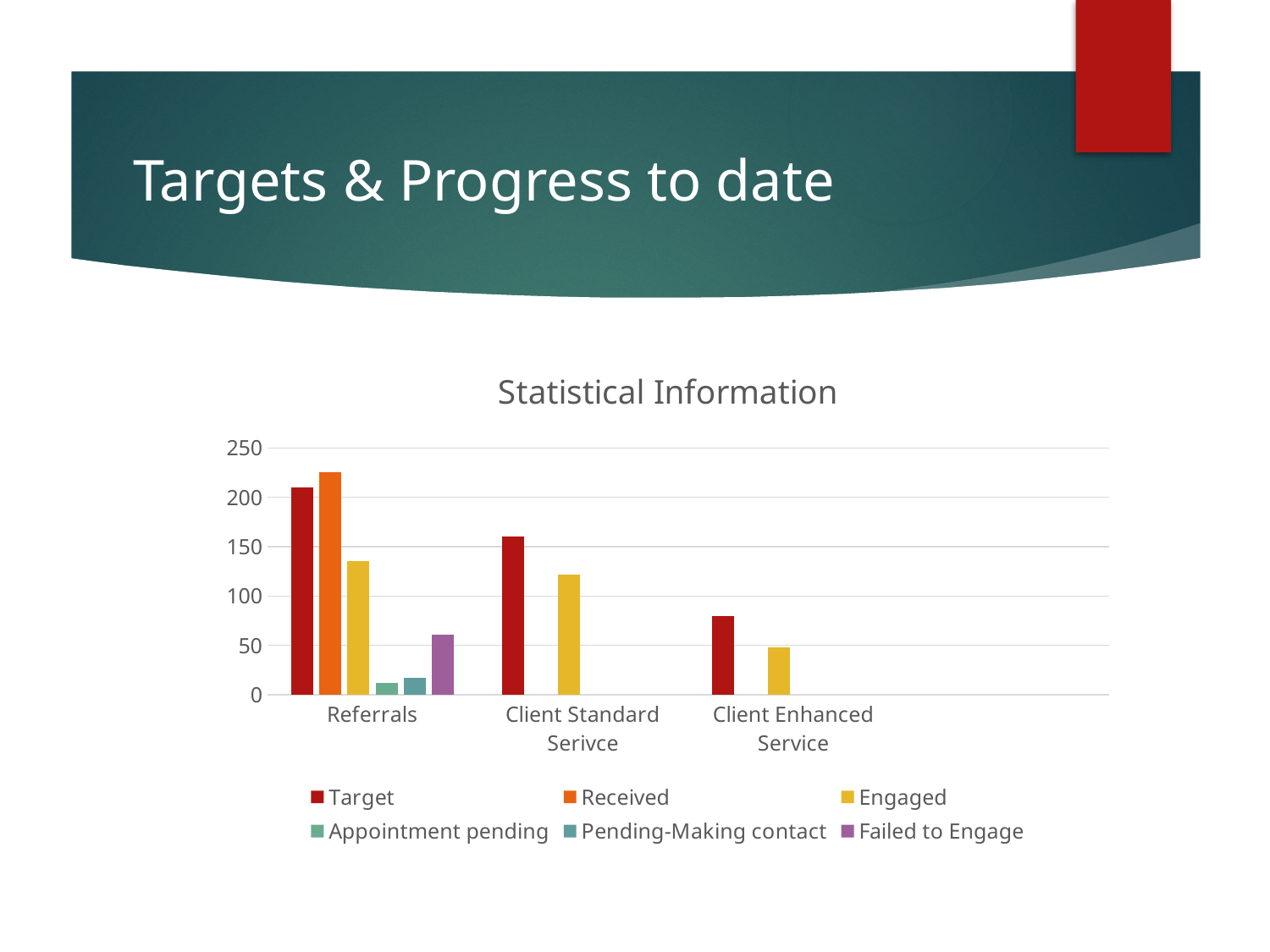
Is the Target value for Client Enhanced Service greater or less than 100? less How many series does the chart's legend list? 6 Is the Appointment pending value for Referrals greater or less than 50? less Is the Engaged value for Referrals greater or less than 100? greater How many categories are shown on the x axis of the chart? 3 What kind of chart is shown on the slide? bar chart Which category has the lowest Engaged value? Client Enhanced Service Which category has the highest Target value? Referrals What is the title of the chart? Statistical Information For Referrals, which is larger: the Target value or the Received value? Received